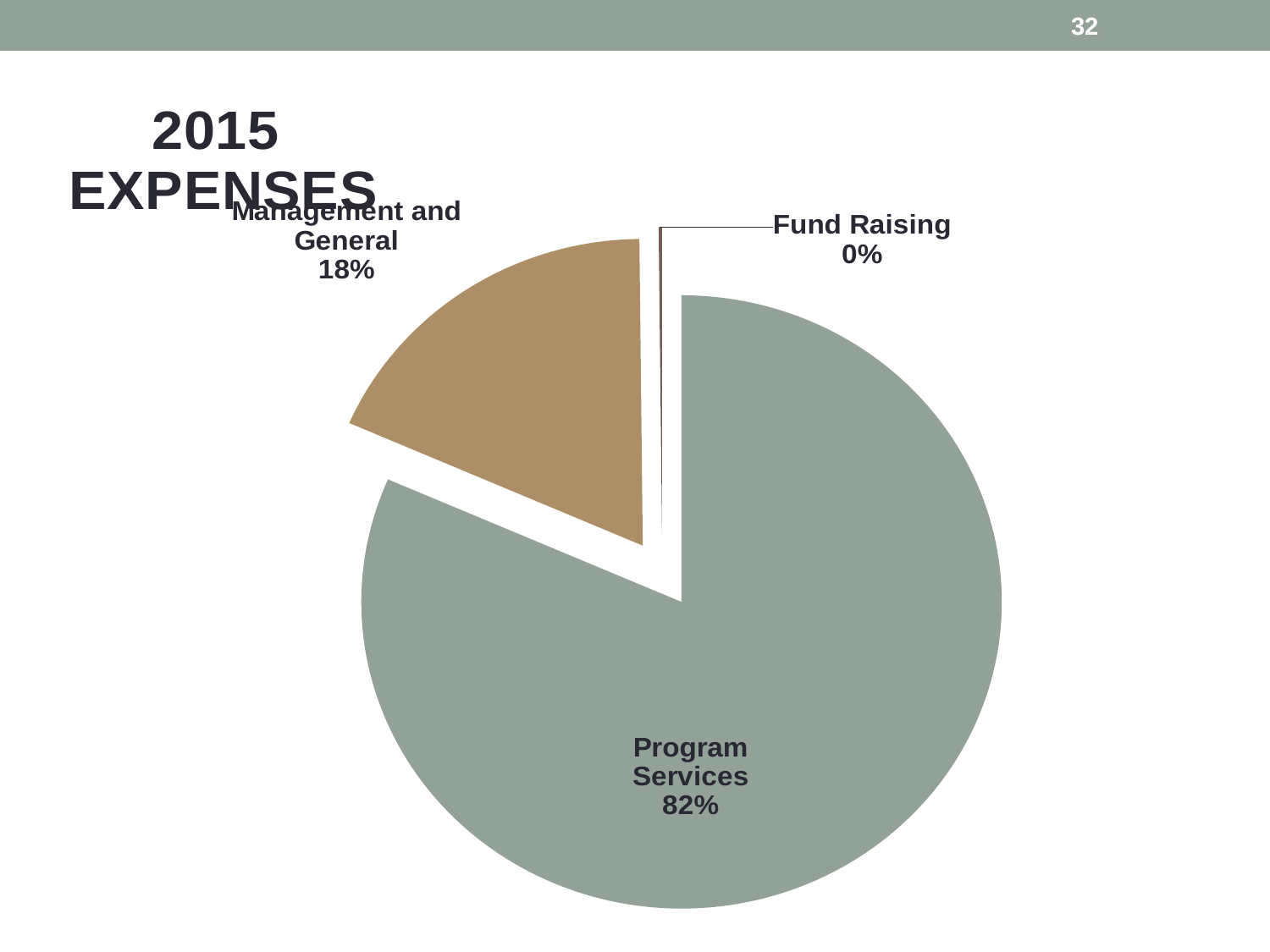
What share of 2015 expenses is Fund Raising? 0% How many categories are shown in the pie chart? 3 What share of 2015 expenses is Program Services? 82% Which is larger, Management and General or Fund Raising? Management and General What kind of chart is shown on the slide? pie chart Which category has the largest share of 2015 expenses? Program Services Which is larger, Program Services or Management and General? Program Services What is the title of the chart? 2015 EXPENSES What colour is the Management and General slice? tan/brown Which category has the smallest share of 2015 expenses? Fund Raising What is the difference in percentage points between Program Services and Management and General? 64 What share of 2015 expenses is Management and General? 18%